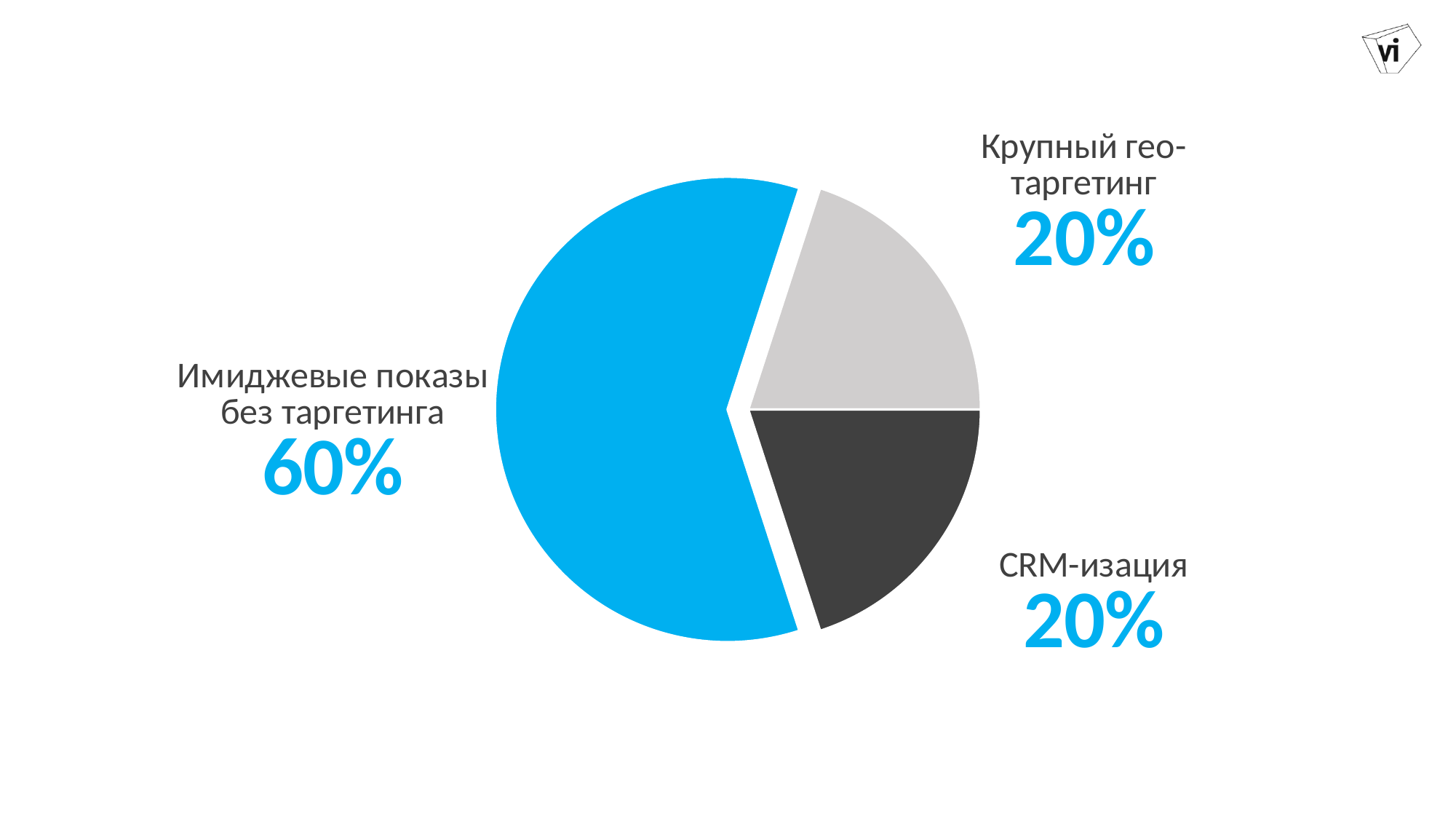
What share of the pie is "Имиджевые показы без таргетинга"? 60% What colour is the slice for "Имиджевые показы без таргетинга"? blue What share of the pie is "Крупный гео-таргетинг"? 20% What kind of chart is shown on the slide? pie chart What colour is the slice for "CRM-изация"? dark grey Which slice of the pie is the largest? Имиджевые показы без таргетинга What is the combined share of "Крупный гео-таргетинг" and "CRM-изация"? 40% What is the difference between the share of "Имиджевые показы без таргетинга" and the share of "CRM-изация"? 40% What share of the pie is "CRM-изация"? 20% Which is larger: the share of "Имиджевые показы без таргетинга" or the share of "Крупный гео-таргетинг"? Имиджевые показы без таргетинга How many slices does the pie chart have? 3